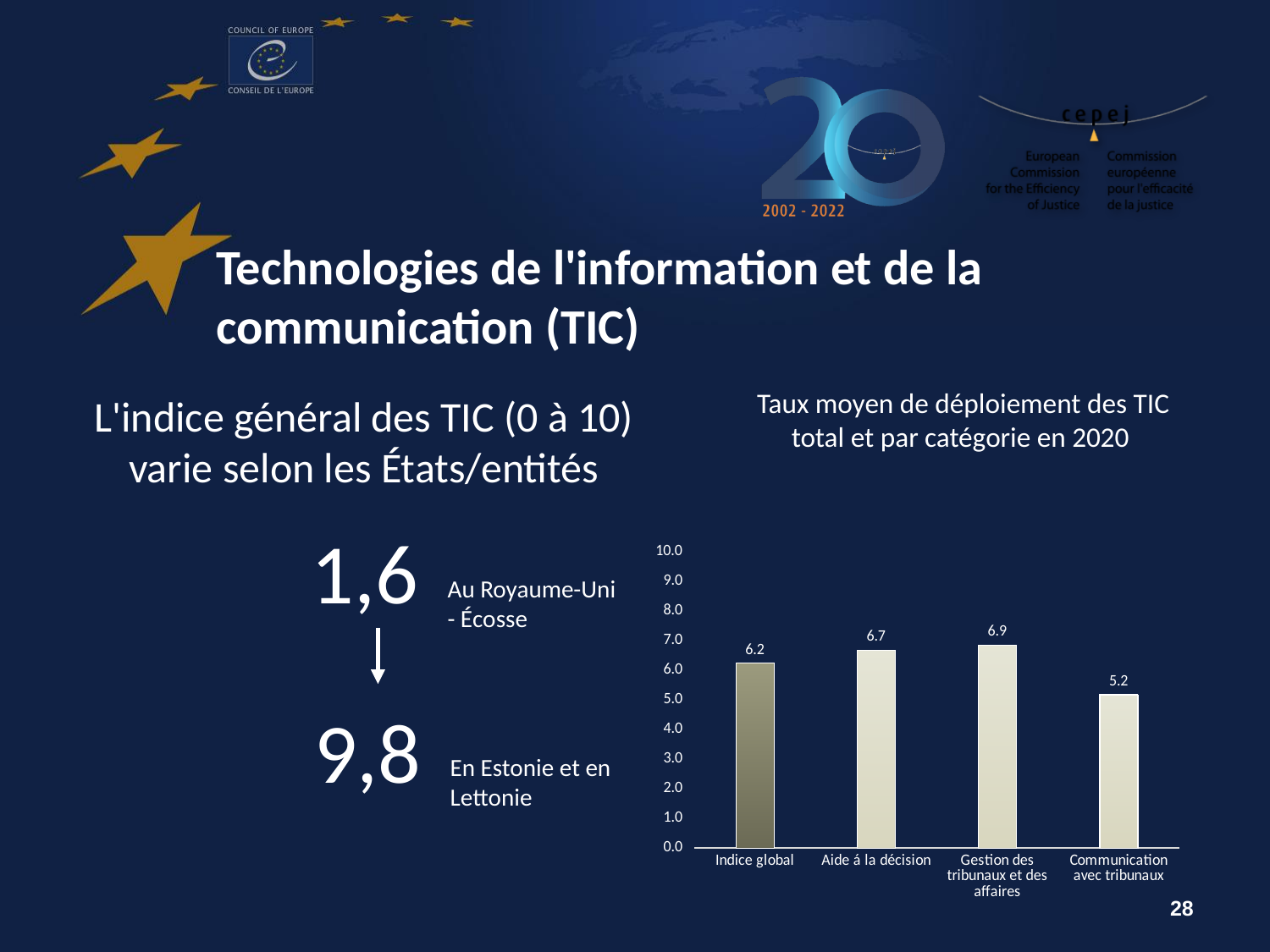
What is the value for Aide á la décision? 6.7 What is the value for Gestion des tribunaux et des affaires? 6.9 What is the title of the chart? Taux moyen de déploiement des TIC total et par catégorie en 2020 Is the value for Communication avec tribunaux greater or less than 6.0? less Which is larger, the value for Aide á la décision or the value for Indice global? Aide á la décision Which category has the highest value? Gestion des tribunaux et des affaires How many categories are shown in the chart? 4 What is the difference between the values for Gestion des tribunaux et des affaires and Communication avec tribunaux? 1.7 Which category has the lowest value? Communication avec tribunaux What is the value for Indice global? 6.2 What is the value for Communication avec tribunaux? 5.2 What kind of chart is shown on the slide? bar chart